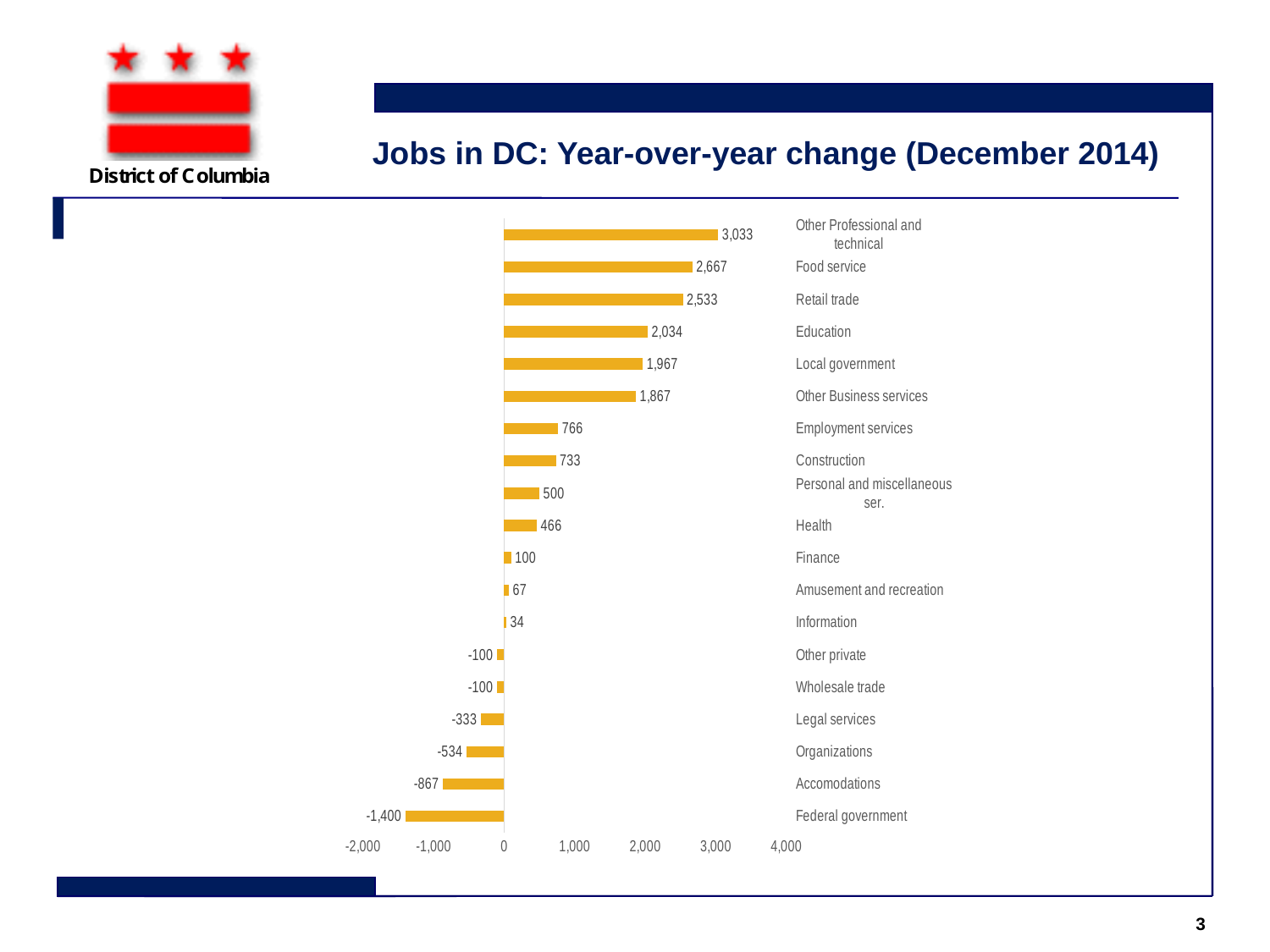
What is the title of the chart? Jobs in DC: Year-over-year change (December 2014) Which is larger, the value for Local government or the value for Other Business services? Local government How many categories are shown in the chart? 19 Is the value for Accomodations greater or less than -1,000? greater What is the value shown for Construction? 733 What kind of chart is shown on the slide? Bar chart Which category has the highest year-over-year job change? Other Professional and technical What is the difference between the values for Retail trade and Education? 499 Which category has the lowest year-over-year job change? Federal government What is the year-over-year job change for Food service? 2,667 What is the value shown for Federal government? -1,400 What is the value shown for Health? 466